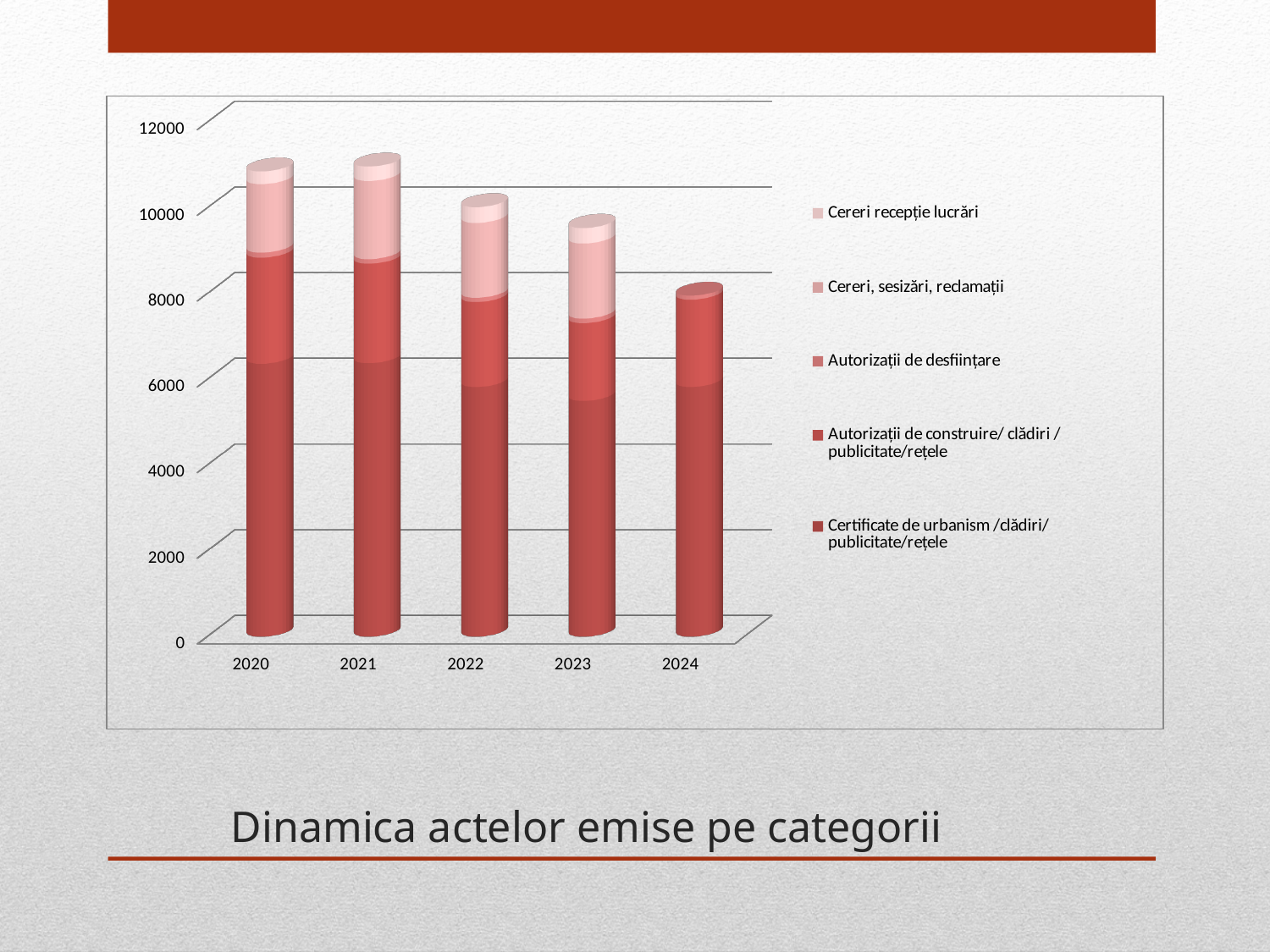
Which year has the lowest total bar in the chart? 2024 What kind of chart is shown on the slide? stacked bar chart What is the title shown below the chart on the slide? Dinamica actelor emise pe categorii Which year has the larger total bar, 2022 or 2024? 2022 Is the total bar for 2023 greater or less than 10000? less Is the total bar for 2023 greater or less than 8000? greater Do the total bar heights generally rise or fall from 2020 to 2024? fall How many years are shown on the x axis of the chart? 5 How many series does the chart's legend list? 5 Is the total bar for 2020 greater or less than 10000? greater Which year has the larger total bar, 2020 or 2023? 2020